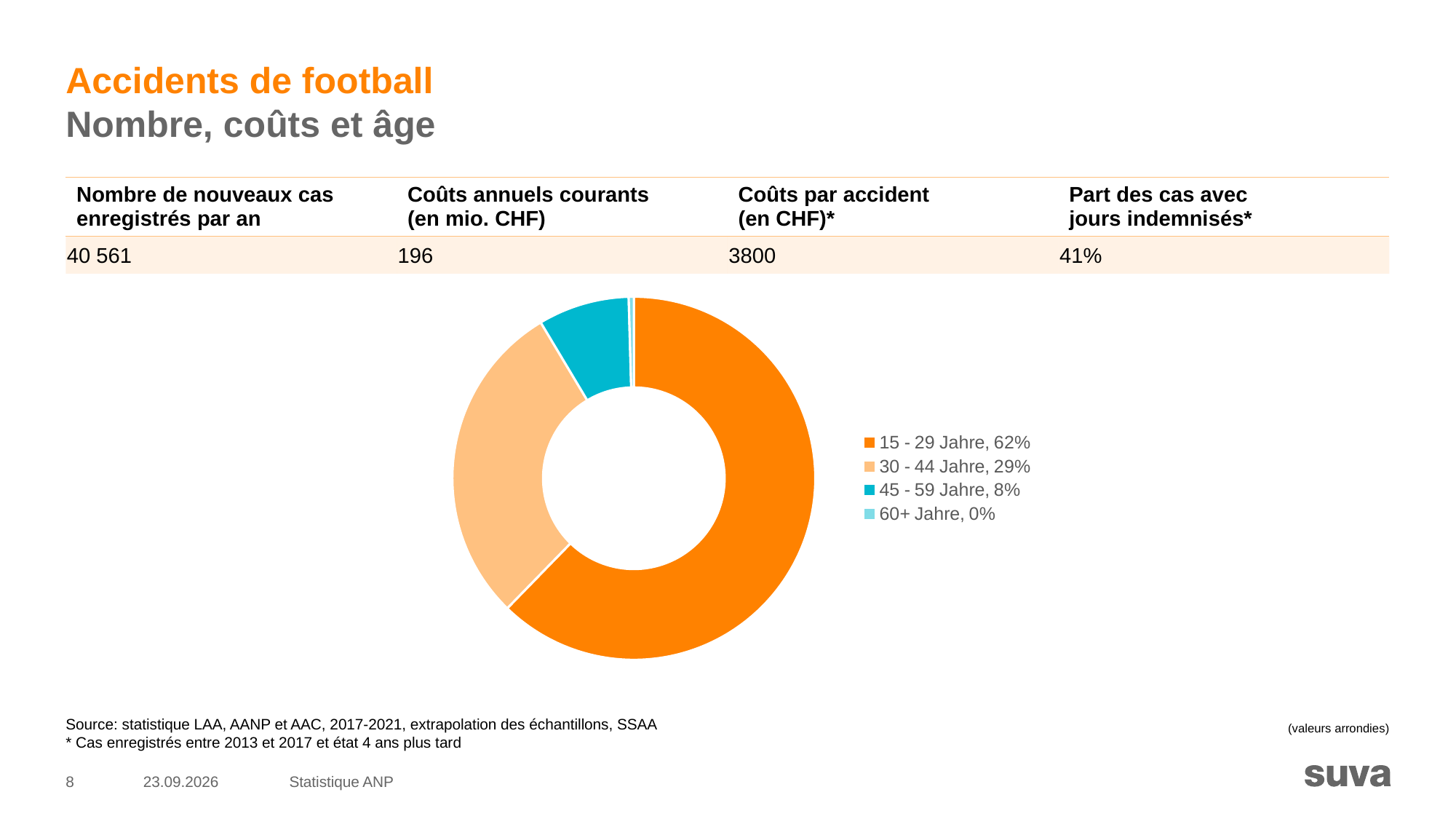
What colour represents the 45 - 59 Jahre age group in the chart? Turquoise (blue) What is the difference in share between the 15 - 29 Jahre and 30 - 44 Jahre age groups? 33 percentage points What share of football accidents falls in the 15 - 29 Jahre age group? 62% Which age group has a larger share: 30 - 44 Jahre or 45 - 59 Jahre? 30 - 44 Jahre What is the combined share of the 15 - 29 Jahre and 30 - 44 Jahre age groups? 91% What share of football accidents falls in the 30 - 44 Jahre age group? 29% What share of football accidents falls in the 45 - 59 Jahre age group? 8% What kind of chart is shown on the slide? Doughnut (pie) chart How many age groups does the legend list? 4 Which age group has the largest share of football accidents? 15 - 29 Jahre Which age group has the smallest share of football accidents? 60+ Jahre What share is shown for the 60+ Jahre age group? 0%